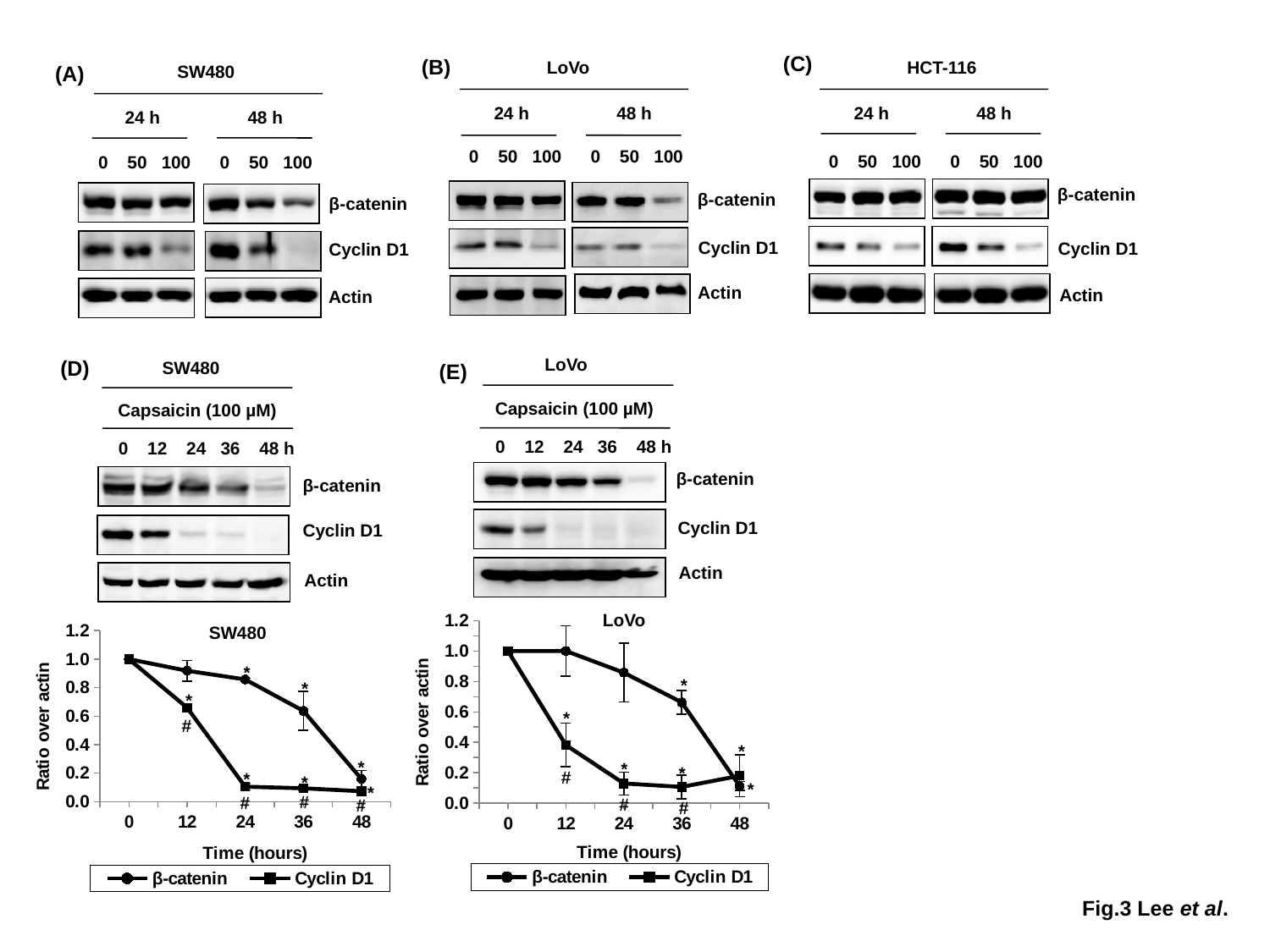
What kind of chart is the SW480 chart at the bottom left? Line chart In the SW480 chart, is the value for Cyclin D1 at 24 hours greater or less than 0.4? less In the LoVo chart, do the Cyclin D1 values rise or fall as time increases from 0 to 48 hours? Fall In the SW480 chart, what is the ratio over actin for β-catenin at 0 hours? 1.0 In the SW480 chart, is the value for β-catenin at 24 hours greater or less than 0.6? greater In the LoVo chart, is the value for β-catenin at 36 hours greater or less than 0.4? greater How many time points are plotted on the x axis of the SW480 chart? 5 In the SW480 chart, which series has the larger value at 12 hours, β-catenin or Cyclin D1? β-catenin In the LoVo chart, what is the ratio over actin for Cyclin D1 at 0 hours? 1.0 What is the y-axis title of the SW480 chart? Ratio over actin How many series does the legend of the LoVo chart list? 2